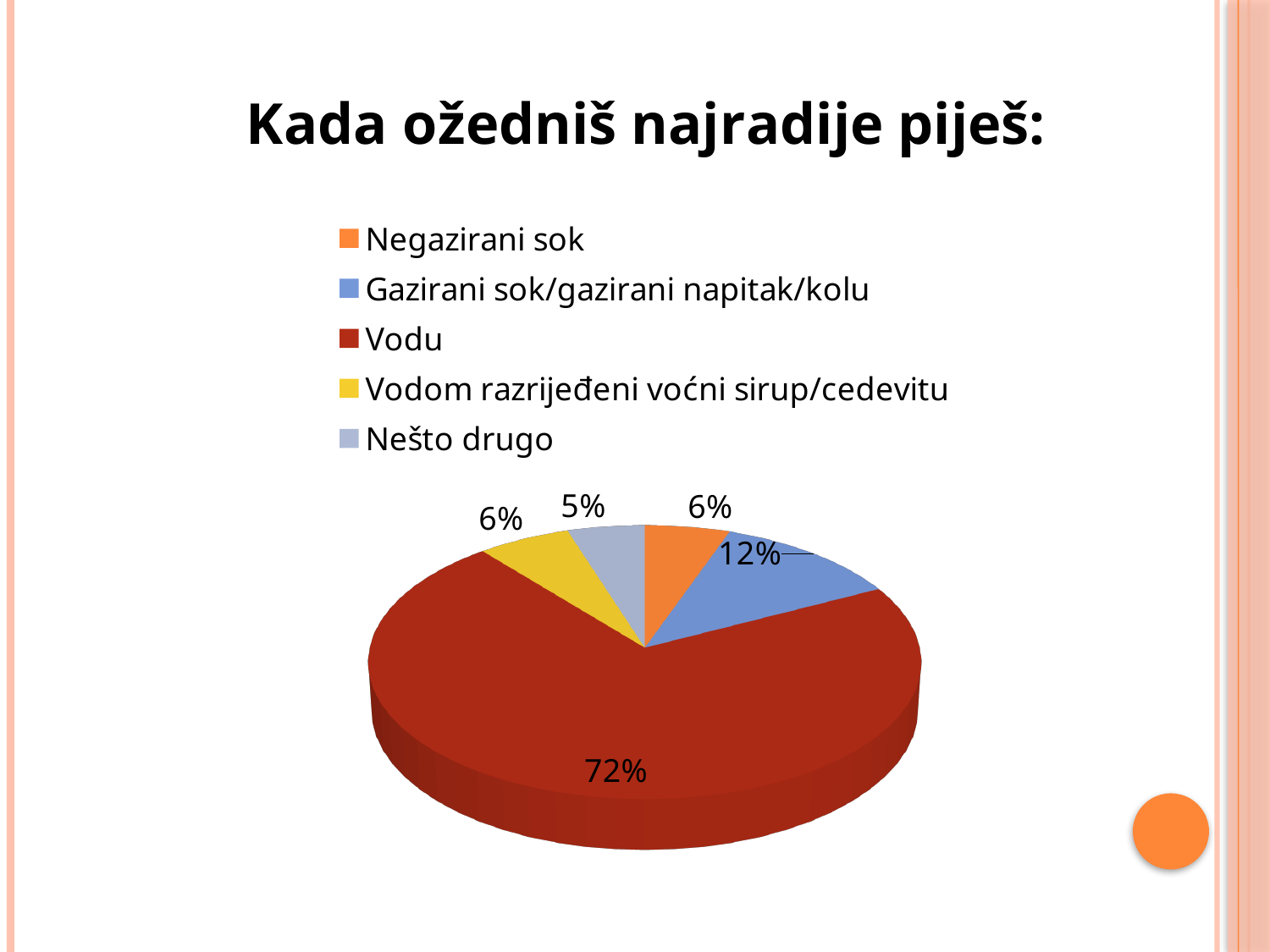
What is the value for "Nešto drugo"? 5% What is the title of the chart? Kada ožedniš najradije piješ: How many categories does the pie chart have? 5 What kind of chart is shown on the slide? pie chart What is the value for "Vodom razrijeđeni voćni sirup/cedevitu"? 6% What share of the pie does "Vodu" take? 72% What is the value for "Negazirani sok"? 6% Which category has the smallest share of the pie? Nešto drugo Which category has the largest share of the pie? Vodu What is the difference between the shares for "Vodu" and "Gazirani sok/gazirani napitak/kolu"? 60% Which is larger: the share for "Gazirani sok/gazirani napitak/kolu" or for "Negazirani sok"? Gazirani sok/gazirani napitak/kolu What is the value for "Gazirani sok/gazirani napitak/kolu"? 12%